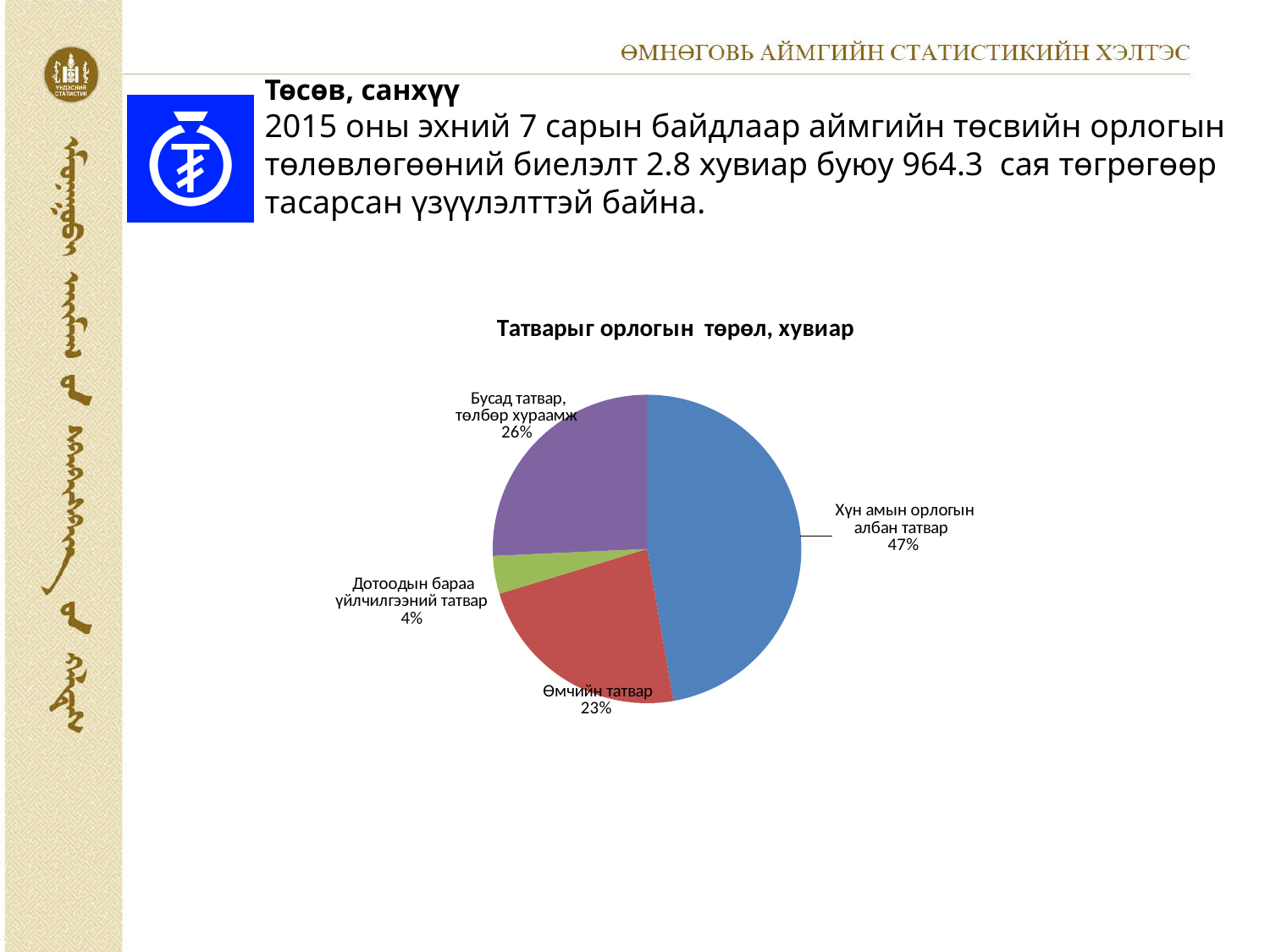
What share of the pie does Бусад татвар, төлбөр хураамж have? 26% What colour is the slice for Өмчийн татвар? red What is the title of the chart? Татварыг орлогын төрөл, хувиар Which category has the smallest slice of the pie? Дотоодын бараа үйлчилгээний татвар What is the difference in percentage points between Хүн амын орлогын албан татвар and Өмчийн татвар? 24 What share of the pie does Өмчийн татвар have? 23% What share of the pie does Хүн амын орлогын албан татвар have? 47% What kind of chart is shown on the slide? pie chart How many slices does the pie chart have? 4 Which category has the largest slice of the pie? Хүн амын орлогын албан татвар Which is larger, Бусад татвар, төлбөр хураамж or Өмчийн татвар? Бусад татвар, төлбөр хураамж